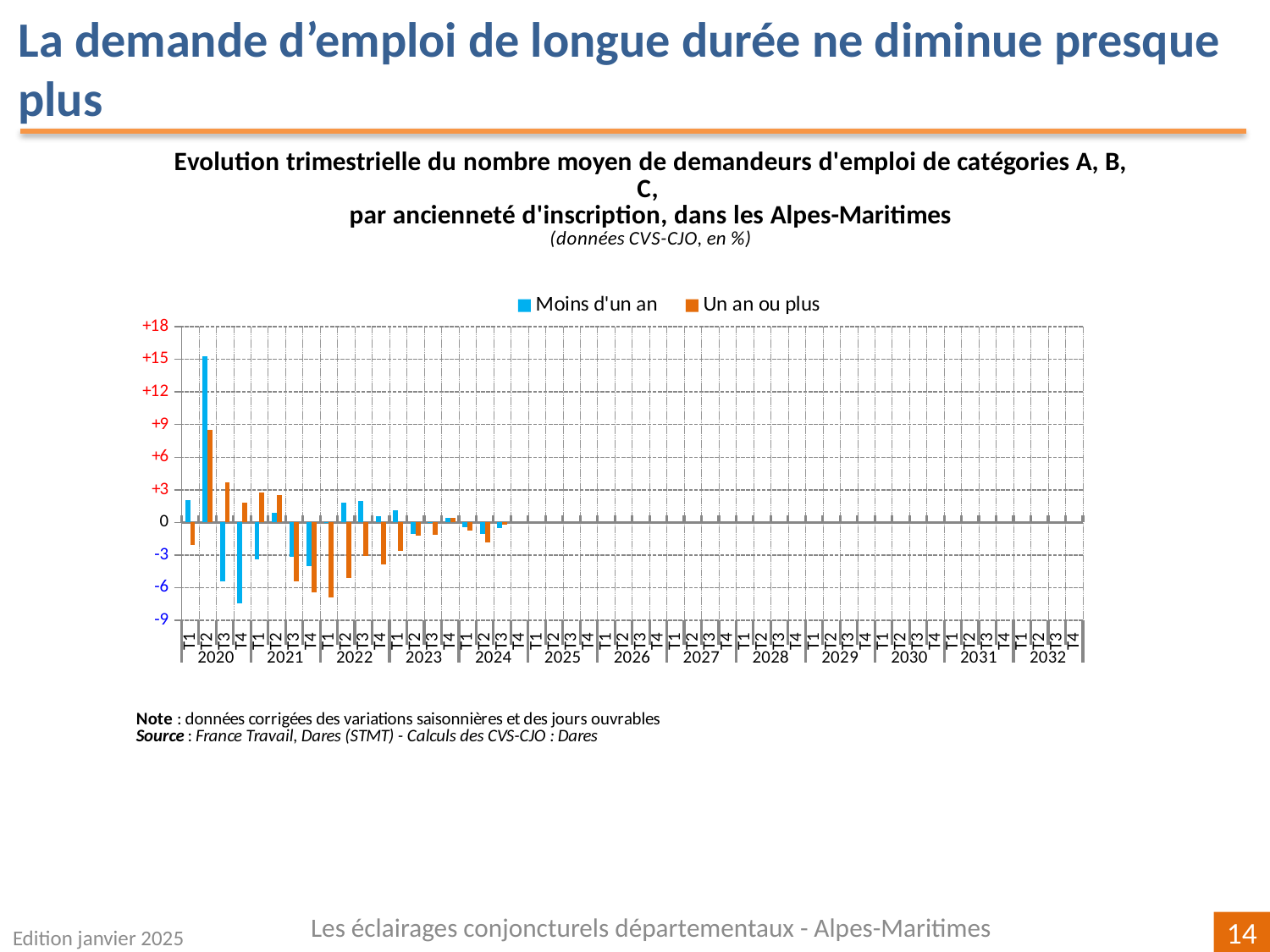
Is the value for 'Moins d'un an' in T2 2020 greater or less than +12? greater In T2 2020, which series has the larger value, 'Moins d'un an' or 'Un an ou plus'? Moins d'un an What kind of chart is shown on the slide? bar chart Which colour represents the series 'Un an ou plus'? orange Is the value for 'Moins d'un an' in T4 2020 greater or less than -6? less How many series does the legend list? 2 In which quarter does the series 'Moins d'un an' reach its lowest value? T4 2020 Is the value for 'Un an ou plus' in T2 2020 greater or less than +6? greater What are the two series named in the legend? Moins d'un an; Un an ou plus In which quarter does the series 'Moins d'un an' reach its highest value? T2 2020 In which quarter does the series 'Un an ou plus' reach its highest value? T2 2020